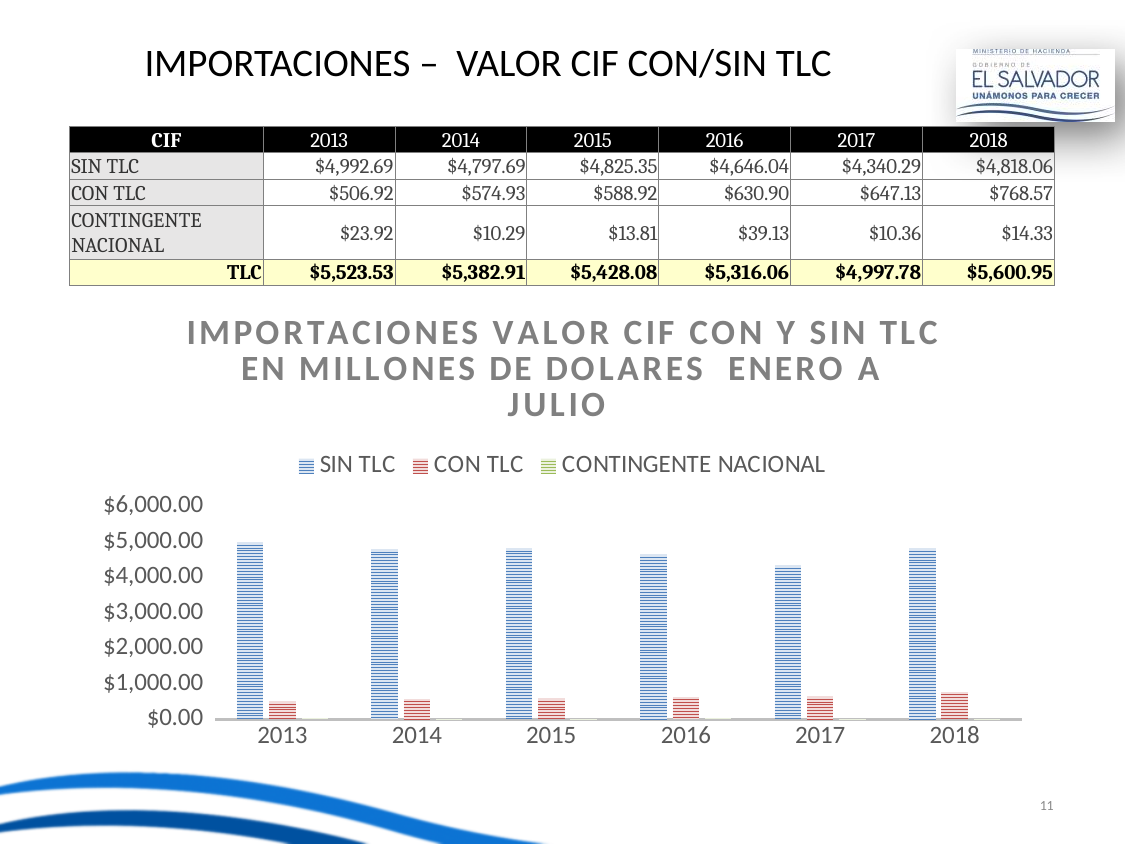
Which year has the lowest SIN TLC value in the chart? 2017 Which year has the highest CON TLC value in the chart? 2018 How many series does the chart legend list? 3 What is the SIN TLC value for 2013 as printed in the table on the slide? $4,992.69 How many years are shown along the x axis of the chart? 6 Is the SIN TLC value larger in 2018 or in 2017? 2018 What is the difference between the CON TLC values for 2018 and 2013, using the values printed in the table? $261.65 Is the SIN TLC value for 2017 greater or less than $4,000.00? greater What kind of chart is shown on the slide? bar chart Do the CON TLC values rise or fall from 2013 to 2018? rise Which year has the highest SIN TLC value in the chart? 2013 Is the CON TLC value for 2018 greater or less than $1,000.00? less